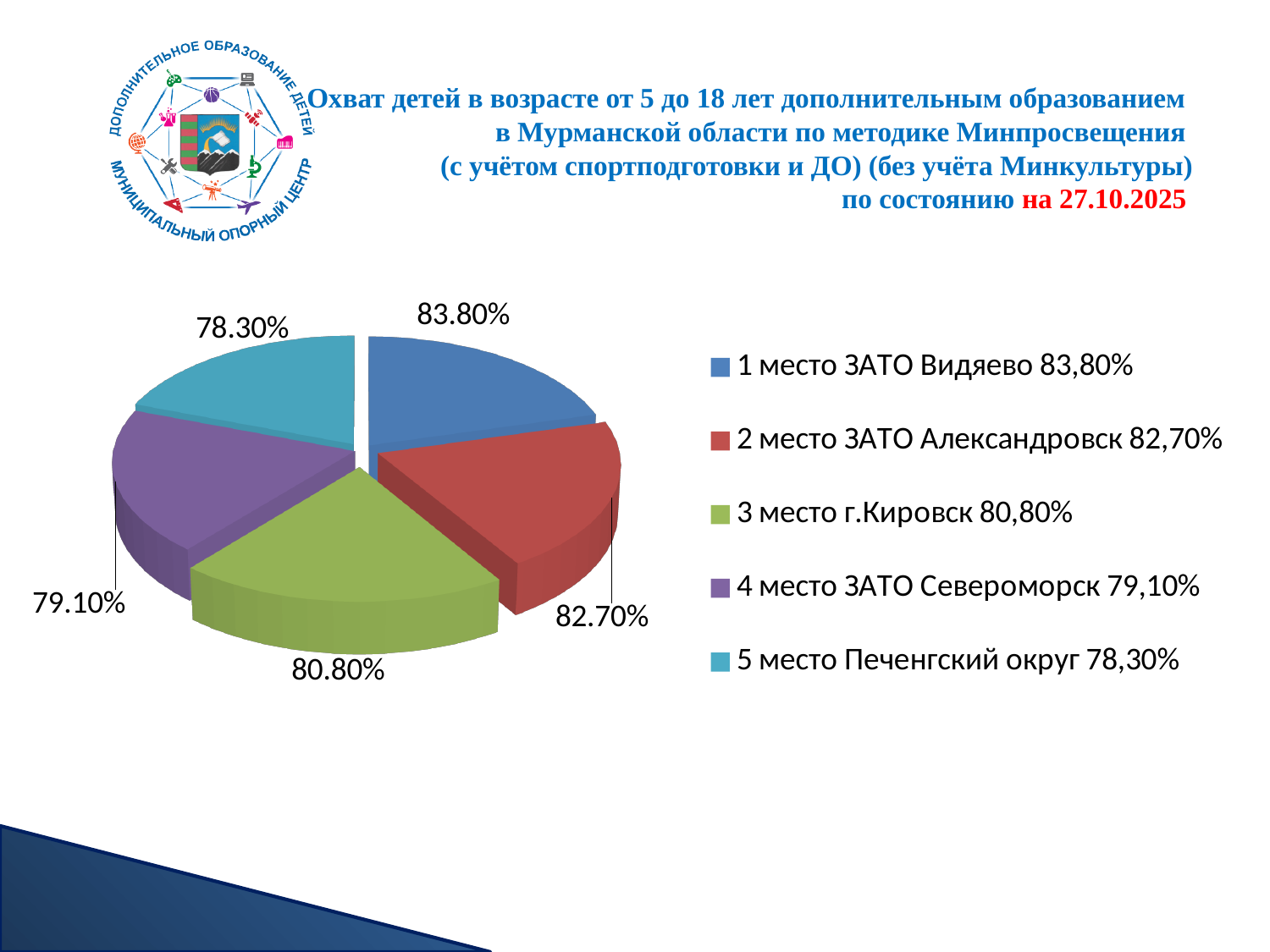
Which category has the lowest value in the pie chart? Печенгский округ Which category has the highest value in the pie chart? ЗАТО Видяево How many slices does the pie chart have? 5 What value is shown for г.Кировск? 80.80% What value is shown for ЗАТО Александровск? 82.70% What kind of chart is shown on the slide? pie chart What value is shown for ЗАТО Видяево? 83.80% What colour is the slice for г.Кировск? green What is the difference between the values for ЗАТО Видяево and ЗАТО Александровск? 1.10% Which is larger, the value for г.Кировск or the value for ЗАТО Североморск? г.Кировск What value is shown for ЗАТО Североморск? 79.10% What value is shown for Печенгский округ? 78.30%